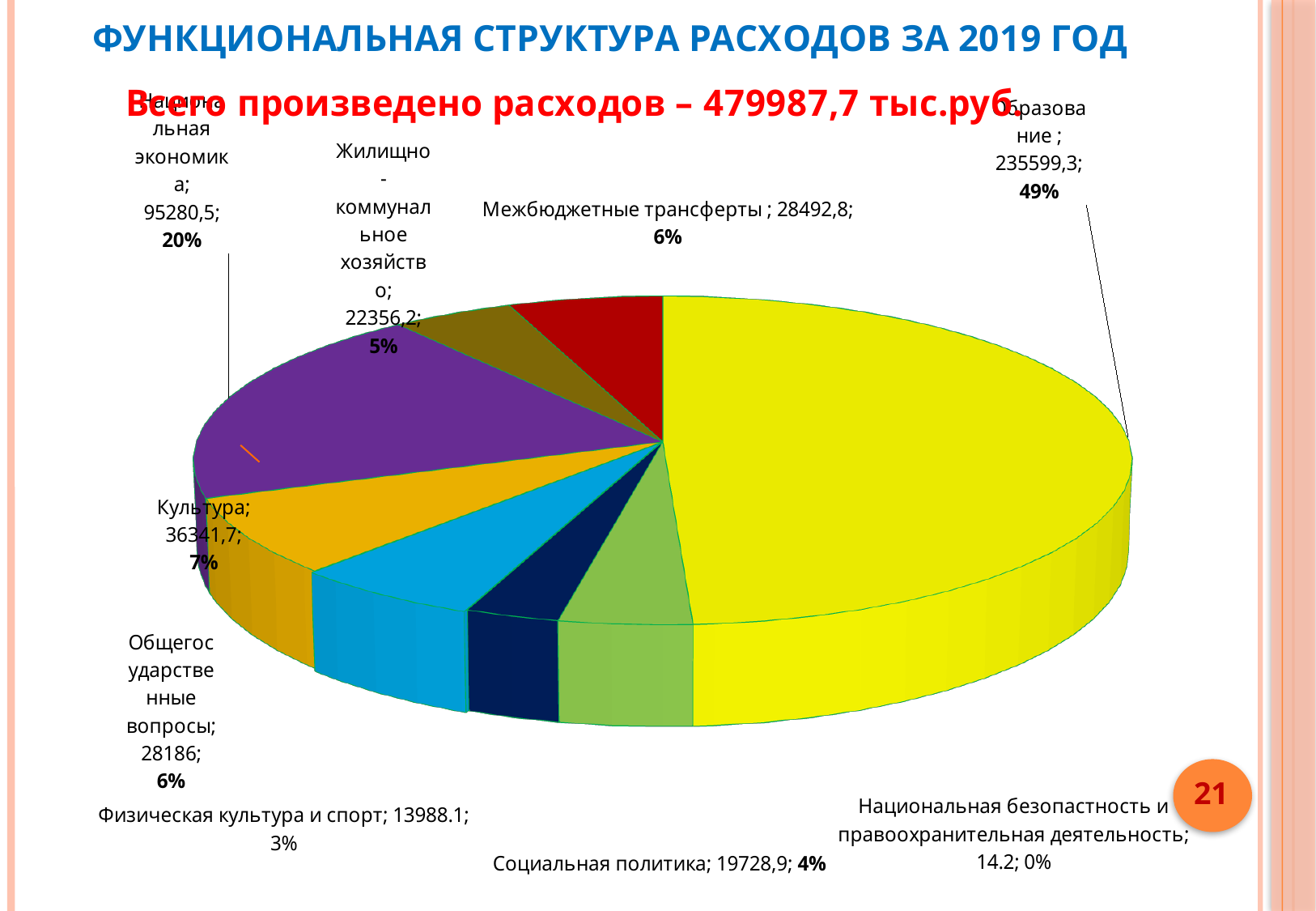
Which is larger, the value for Культура or the value for Общегосударственные вопросы? Культура What is the difference between the value for Межбюджетные трансферты and the value for Общегосударственные вопросы? 306,8 Which category has the smallest slice of the pie? Национальная безопастность и правоохранительная деятельность How many categories are shown in the pie chart? 9 What kind of chart is shown on the slide? pie chart What is the title of the slide? ФУНКЦИОНАЛЬНАЯ СТРУКТУРА РАСХОДОВ ЗА 2019 ГОД Which category has the largest slice of the pie? Образование What is the value for Образование? 235599,3 What is the value for Социальная политика? 19728,9 What share of the pie does Образование take? 49% What share of the pie does Жилищно-коммунальное хозяйство take? 5% What is the value for Культура? 36341,7